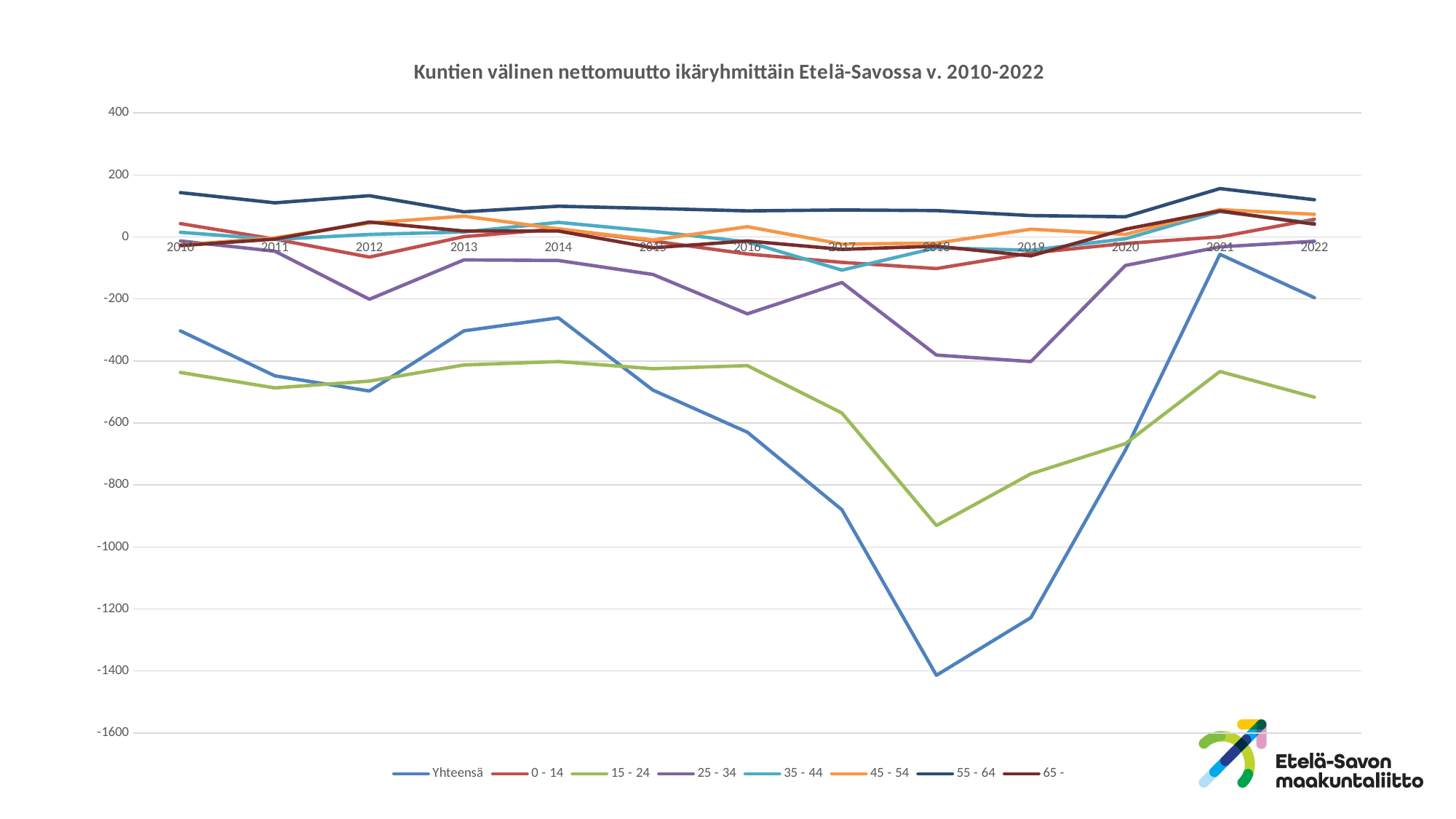
Is the value for 55 - 64 in 2010 greater or less than 100? greater In which year does the 15 - 24 series reach its lowest value? 2018 Which is larger, the Yhteensä value in 2021 or in 2022? 2021 Does the Yhteensä series rise or fall from 2014 to 2018? Fall In which year does the Yhteensä series reach its highest value? 2021 In which year does the Yhteensä series reach its lowest value? 2018 Is the value for 15 - 24 in 2018 greater or less than -800? less Is the value for Yhteensä in 2018 greater or less than -1200? less How many series does the legend list? 8 What is the title of the chart? Kuntien välinen nettomuutto ikäryhmittäin Etelä-Savossa v. 2010-2022 What kind of chart is shown on the slide? Line chart How many years are plotted along the x axis? 13